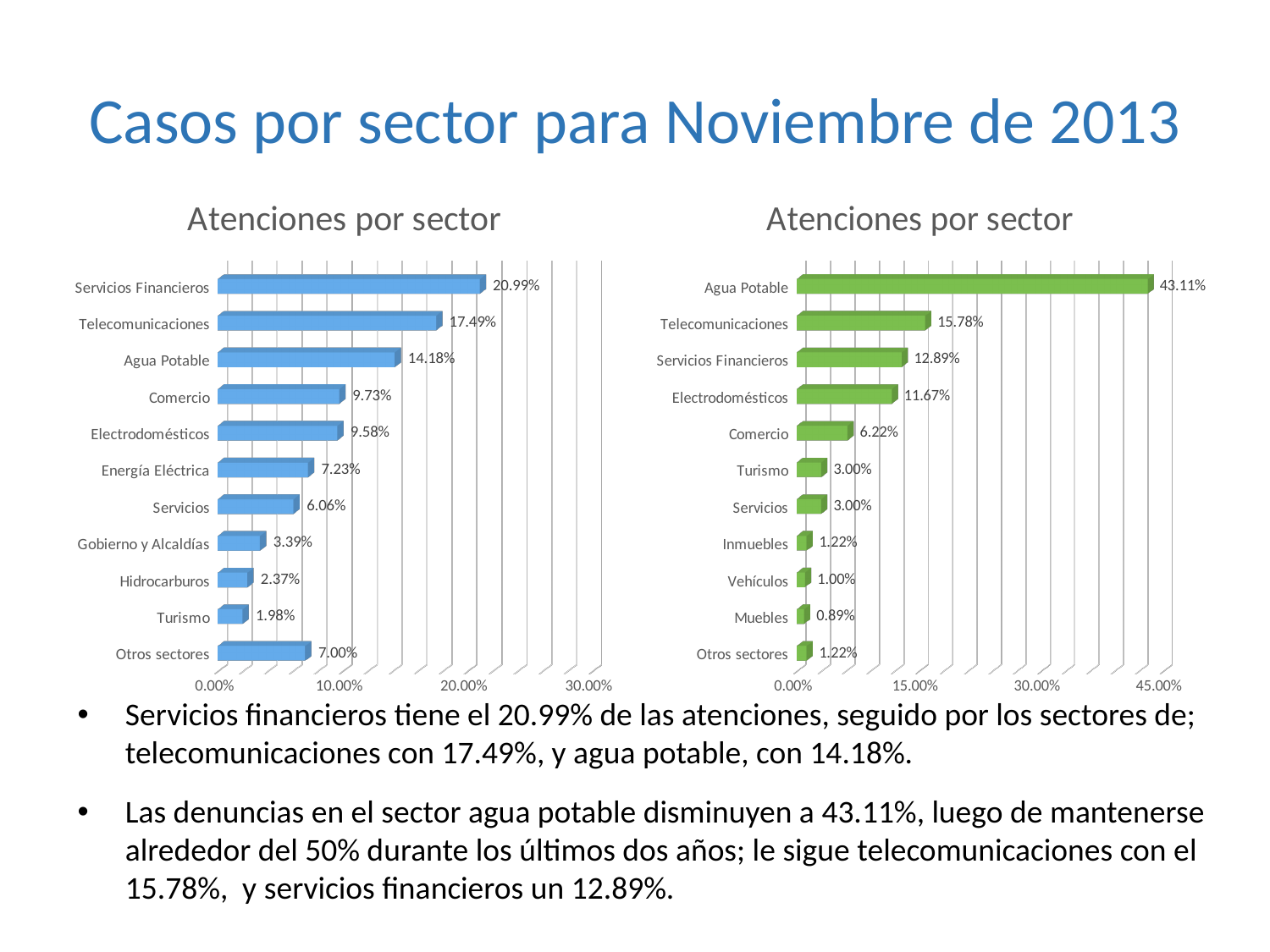
In the right chart, what is the value for Agua Potable? 43.11% In the right chart, which category has the highest value? Agua Potable In the left chart, which category has the lowest value? Turismo In the right chart, which category has the lowest value? Muebles How many categories are shown in the right chart? 11 In the right chart, what is the difference between Agua Potable and Telecomunicaciones? 27.33% In the left chart, what is the value for Hidrocarburos? 2.37% In the right chart, what is the value for Electrodomésticos? 11.67% In the left chart, what is the difference between Servicios Financieros and Telecomunicaciones? 3.50% What type of chart is the left chart? Bar chart In the left chart, which is larger: Comercio or Otros sectores? Comercio In the left chart, what is the value for Servicios Financieros? 20.99%